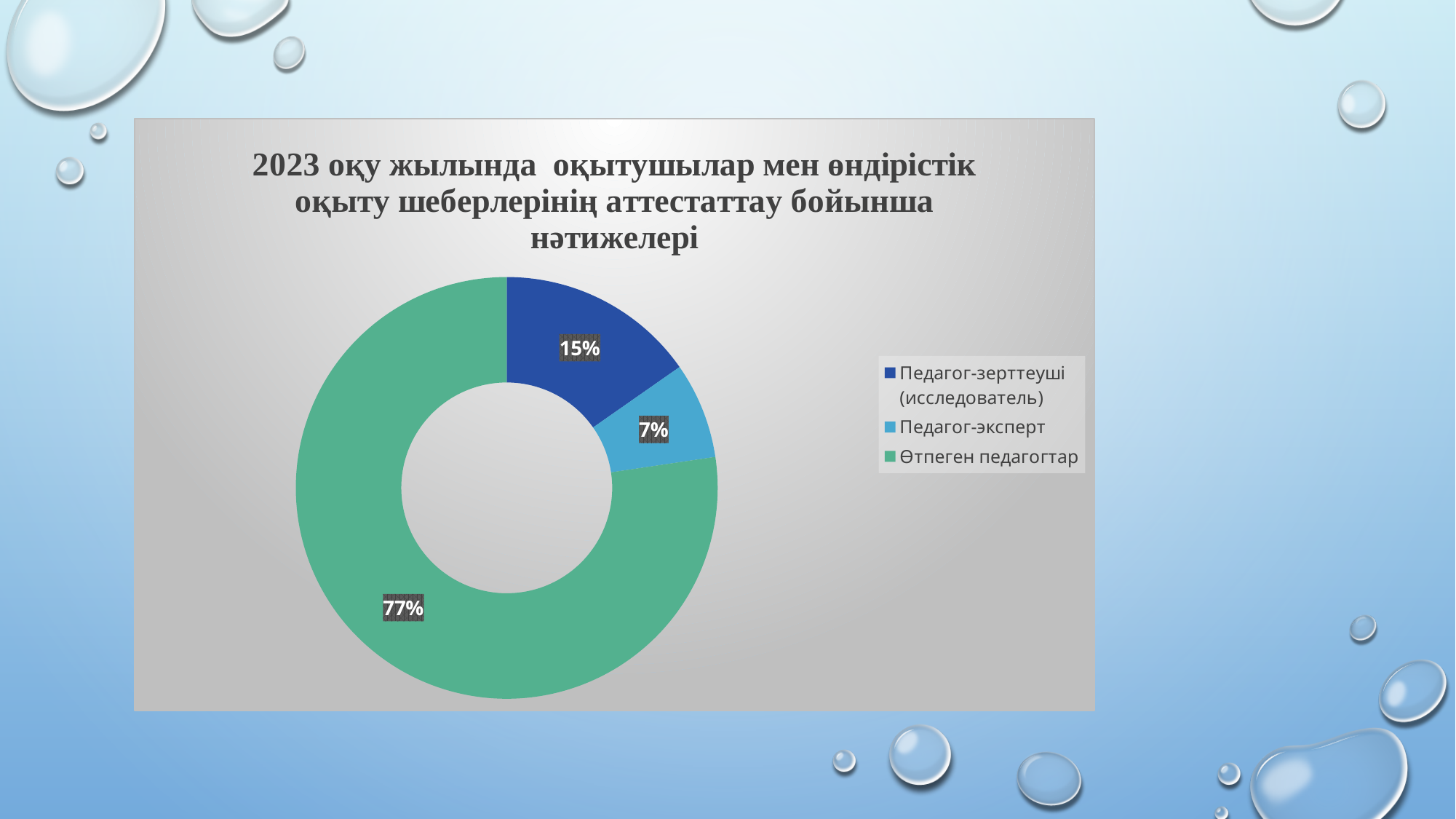
What kind of chart is shown on the slide? Doughnut (pie) chart What is the difference in percentage points between Өтпеген педагогтар and Педагог-зерттеуші (исследователь)? 62 What share of the chart does Педагог-зерттеуші (исследователь) represent? 15% What share of the chart does Өтпеген педагогтар represent? 77% How many entries does the legend list? 3 How many categories are shown in the chart? 3 What share of the chart does Педагог-эксперт represent? 7% Which category has the smallest share of the chart? Педагог-эксперт Which category has the largest share of the chart? Өтпеген педагогтар What colour is the segment for Өтпеген педагогтар? Green What is the difference in percentage points between Педагог-зерттеуші (исследователь) and Педагог-эксперт? 8 Which is larger: the share for Педагог-зерттеуші (исследователь) or the share for Педагог-эксперт? Педагог-зерттеуші (исследователь)